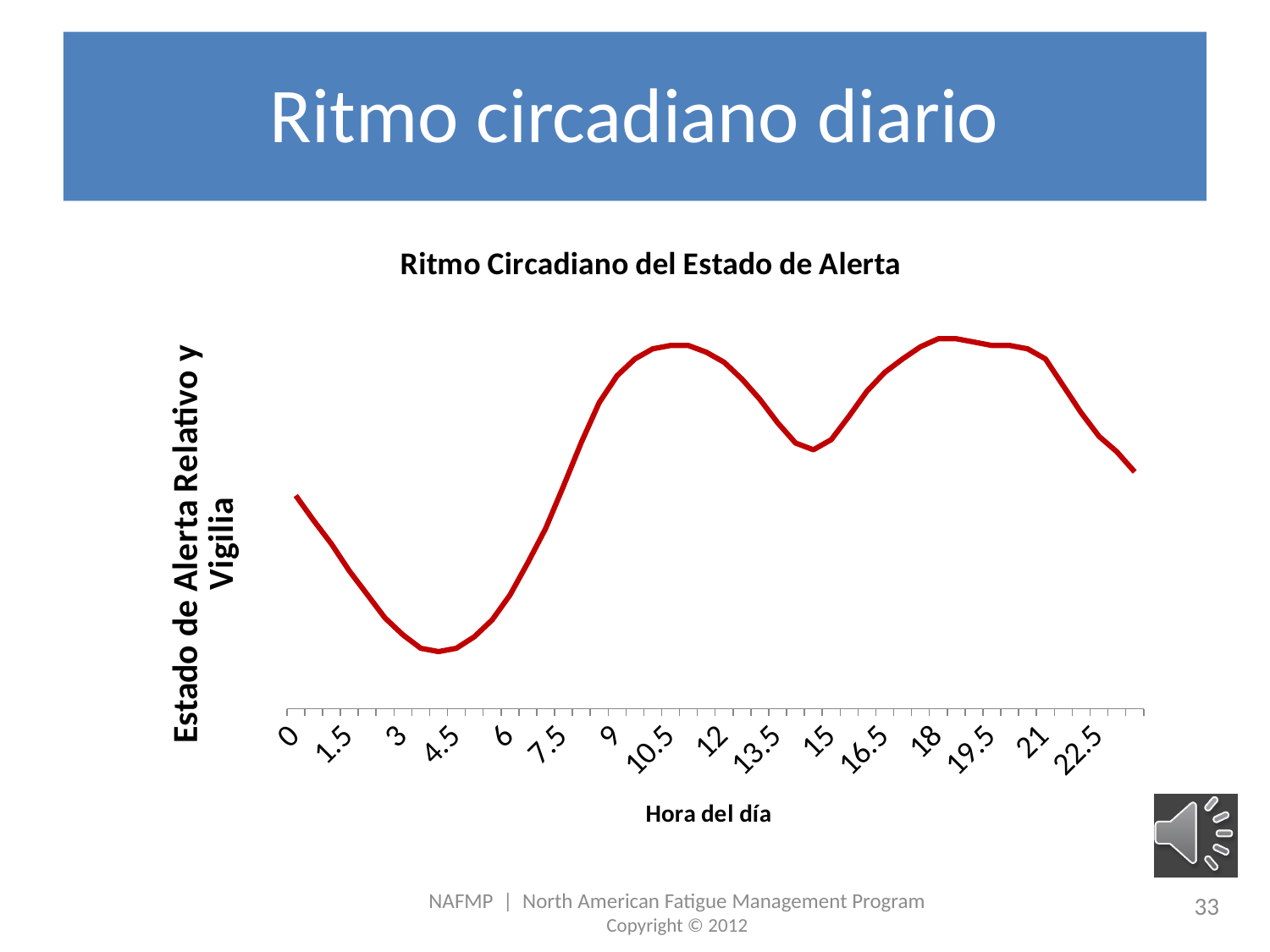
Does the line rise or fall between hour 21 and hour 22.5? fall Which is higher on the line, the value at hour 9 or the value at hour 3? hour 9 Does the line rise or fall between hour 15 and hour 18? rise Does the line rise or fall between hour 0 and hour 4.5? fall What is the label of the x axis of the chart? Hora del día Which is higher on the line, the value at hour 0 or the value at hour 18? hour 18 What kind of chart is shown on the slide? line chart What is the title of the chart? Ritmo Circadiano del Estado de Alerta How many hour labels are shown along the x axis? 16